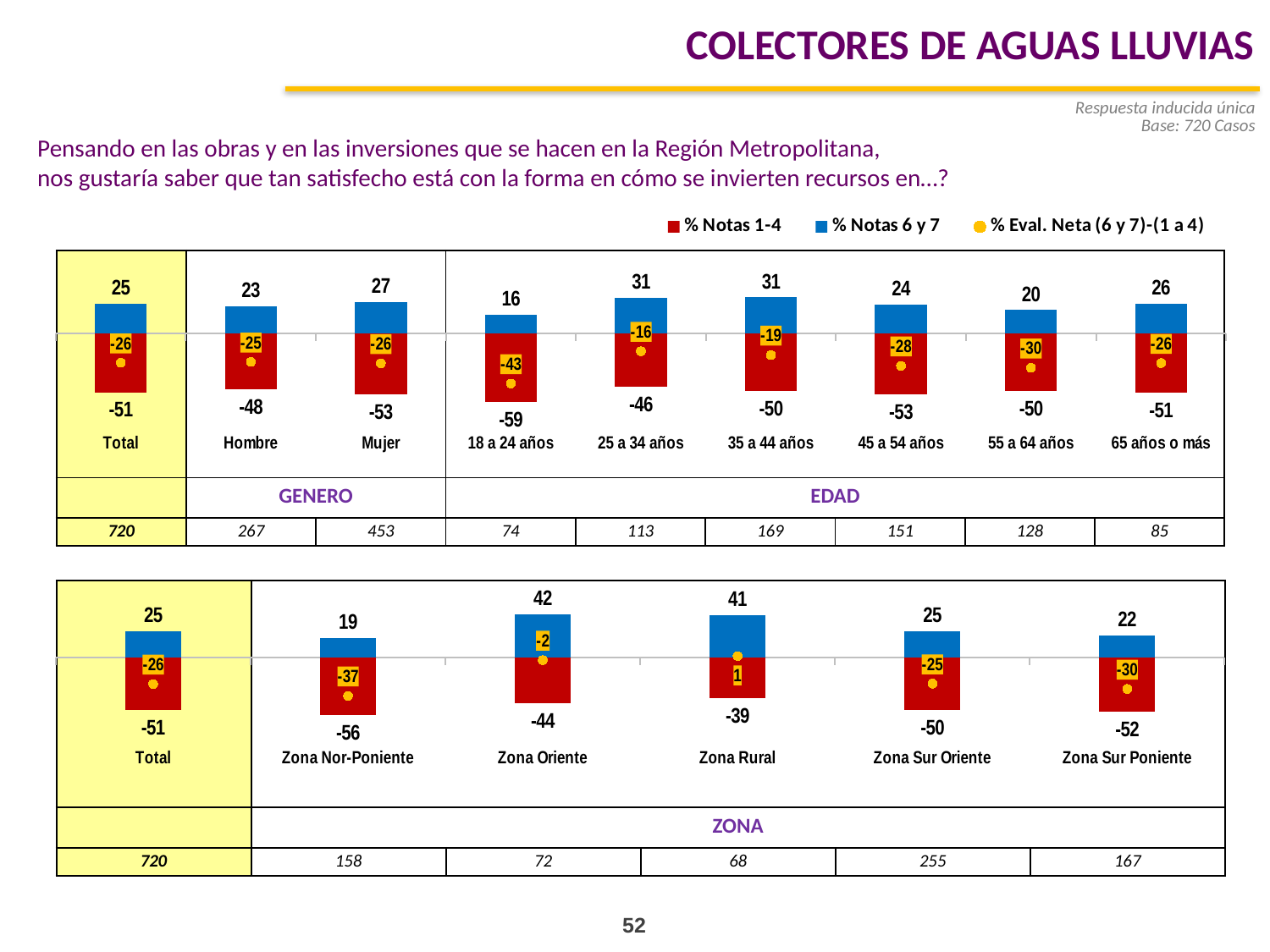
In the top chart, what is the % Notas 1-4 value for Mujer? -53 In the top chart, what is the % Eval. Neta value for 25 a 34 años? -16 What kind of chart is the top chart? Combination bar and line chart (bars with dot markers) In the top chart, which age group has the lowest % Notas 6 y 7 value? 18 a 24 años In the bottom chart, which has a higher % Notas 6 y 7 value, Zona Nor-Poniente or Zona Sur Poniente? Zona Sur Poniente How many series does the legend list? 3 In the bottom chart, which zone has the highest % Notas 6 y 7 value? Zona Oriente In the top chart, what is the % Notas 6 y 7 value for 18 a 24 años? 16 In the bottom chart, what is the % Notas 1-4 value for Zona Nor-Poniente? -56 In the bottom chart, how many categories are plotted? 6 In the bottom chart, what is the % Eval. Neta value for Zona Rural? 1 In the top chart, what is the difference between the % Notas 6 y 7 values for Mujer and Hombre? 4